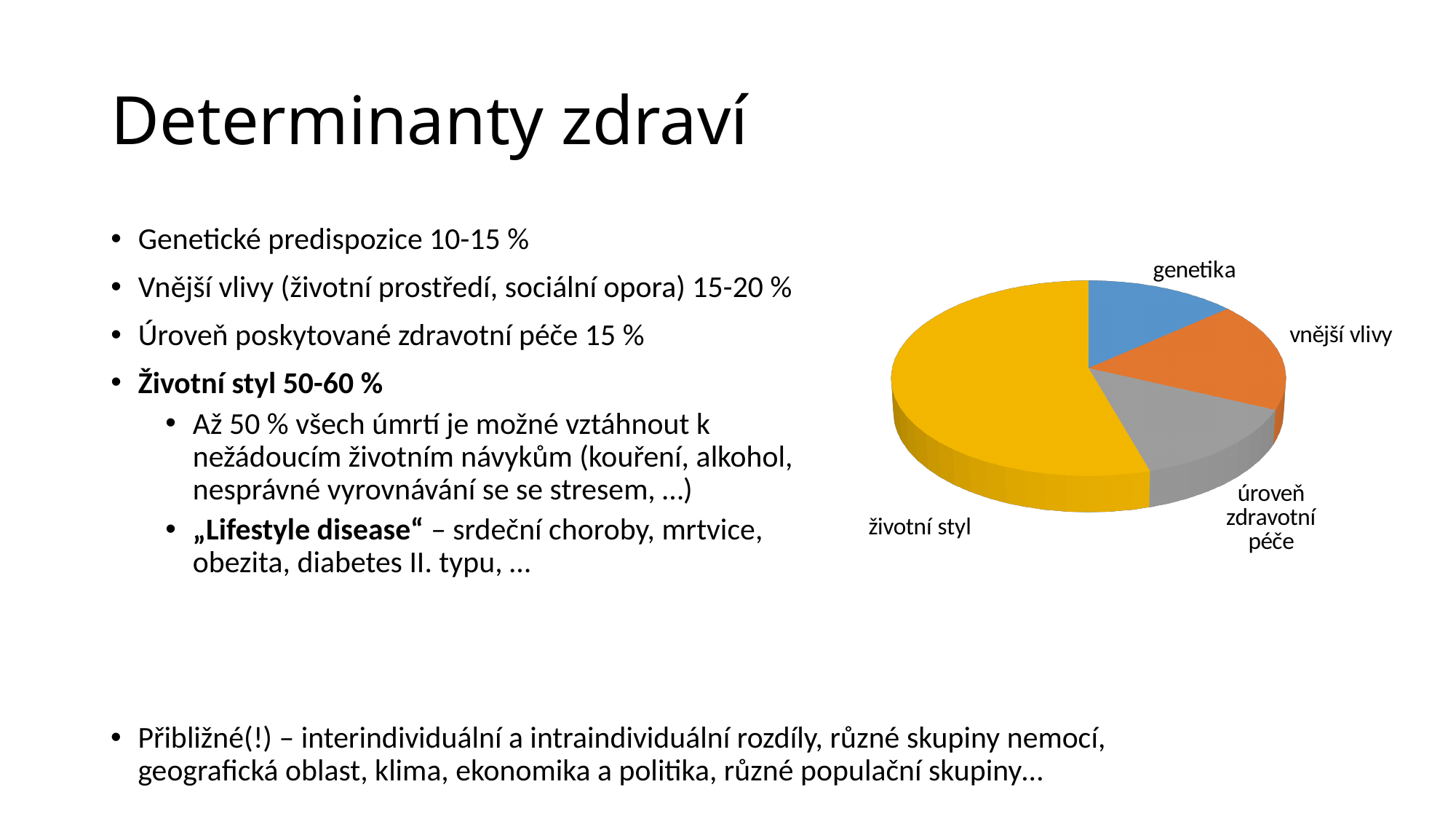
What kind of chart is shown on the slide? pie chart Which slice is larger in the pie chart, životní styl or úroveň zdravotní péče? životní styl Which slice of the pie chart is the largest? životní styl What colour is the životní styl slice in the pie chart? yellow Which slice is larger in the pie chart, vnější vlivy or genetika? vnější vlivy How many slices does the pie chart have? 4 Which slice of the pie chart is coloured blue? genetika Which slice is larger in the pie chart, životní styl or genetika? životní styl